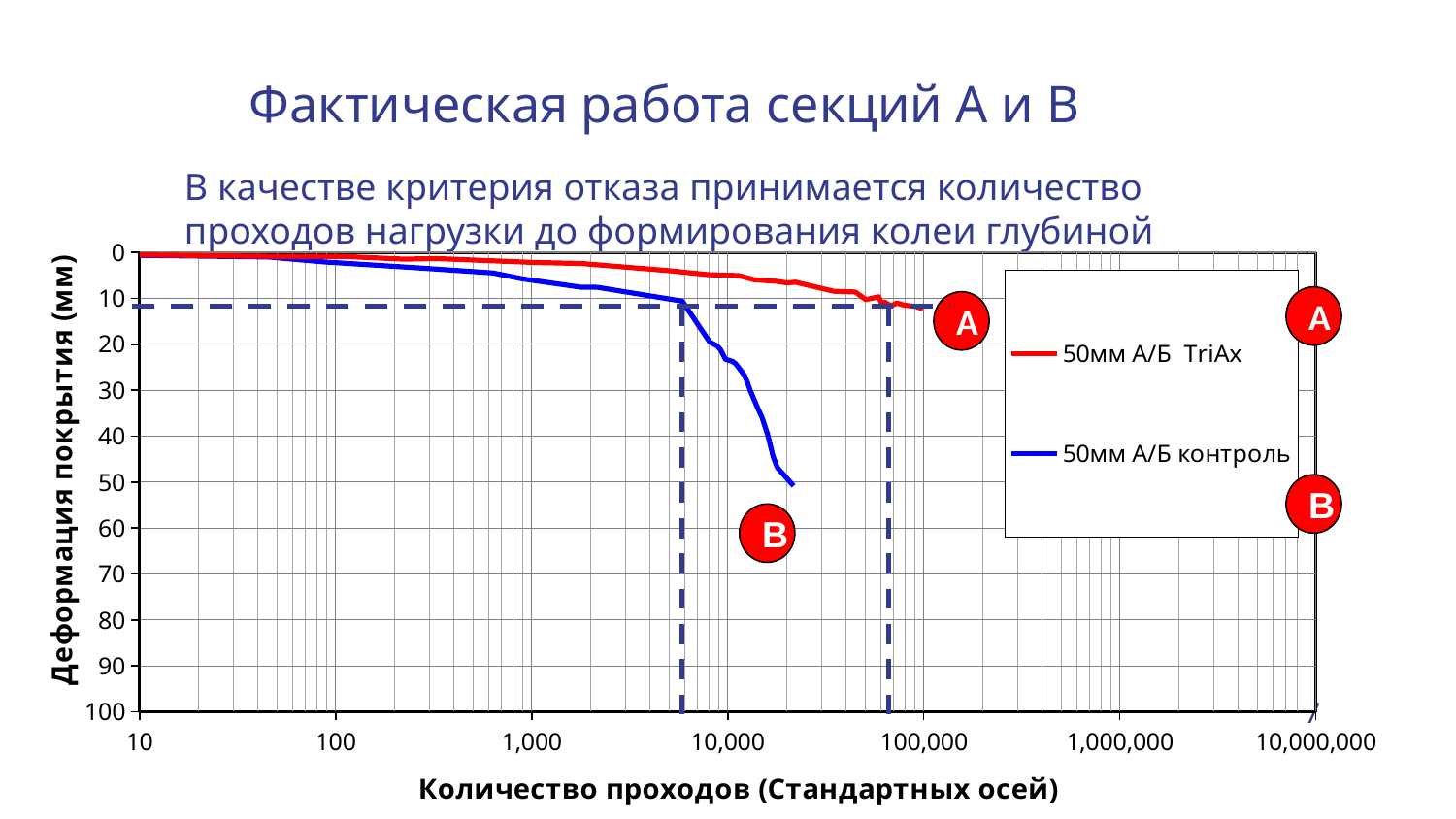
Is the deformation of the 50мм А/Б контроль series at 10,000 passes greater or less than 10 mm? greater Which series is drawn in red in the chart? 50мм А/Б TriAx What kind of chart is shown on the slide? Line chart Which series reaches a larger number of passes before its line ends: 50мм А/Б TriAx or 50мм А/Б контроль? 50мм А/Б TriAx Does the deformation of both series increase or decrease as the number of passes grows along the x axis? Increase Is the deformation of the 50мм А/Б TriAx series at 10,000 passes greater or less than 10 mm? less Which series is drawn in blue in the chart? 50мм А/Б контроль What is the largest value labelled on the x axis of the chart? 10,000,000 Is the final deformation reached by the 50мм А/Б контроль series greater or less than 40 mm? greater How many series does the chart legend list? 2 Which series shows the larger deformation at 10,000 passes: 50мм А/Б TriAx or 50мм А/Б контроль? 50мм А/Б контроль How many labelled tick values are shown on the x axis of the chart? 7